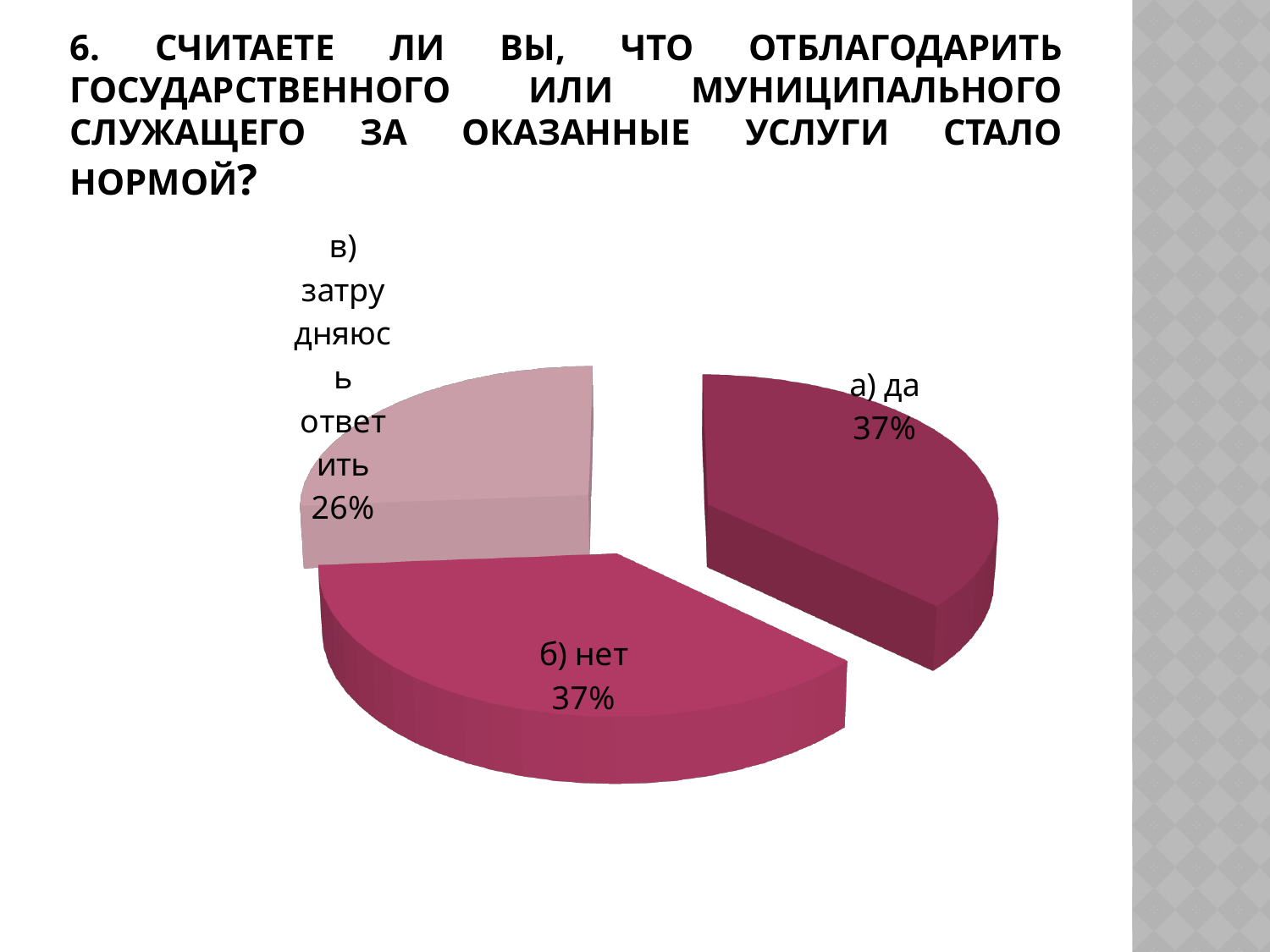
What kind of chart is shown on the slide? pie chart Which is larger: the share for "а) да" or the share for "в) затрудняюсь ответить"? а) да By how many percentage points does "б) нет" exceed "в) затрудняюсь ответить"? 11 What share of the pie does "в) затрудняюсь ответить" represent? 26% Which slice of the pie chart is the smallest? в) затрудняюсь ответить Which is larger: the share for "б) нет" or the share for "в) затрудняюсь ответить"? б) нет Which slice of the pie chart is drawn in the lightest colour? в) затрудняюсь ответить What percentage is shown for the slice "а) да"? 37% What percentage is shown for the slice "в) затрудняюсь ответить"? 26% Do the slices "а) да" and "б) нет" have the same percentage? yes How many slices does the pie chart have? 3 What percentage is shown for the slice "б) нет"? 37%